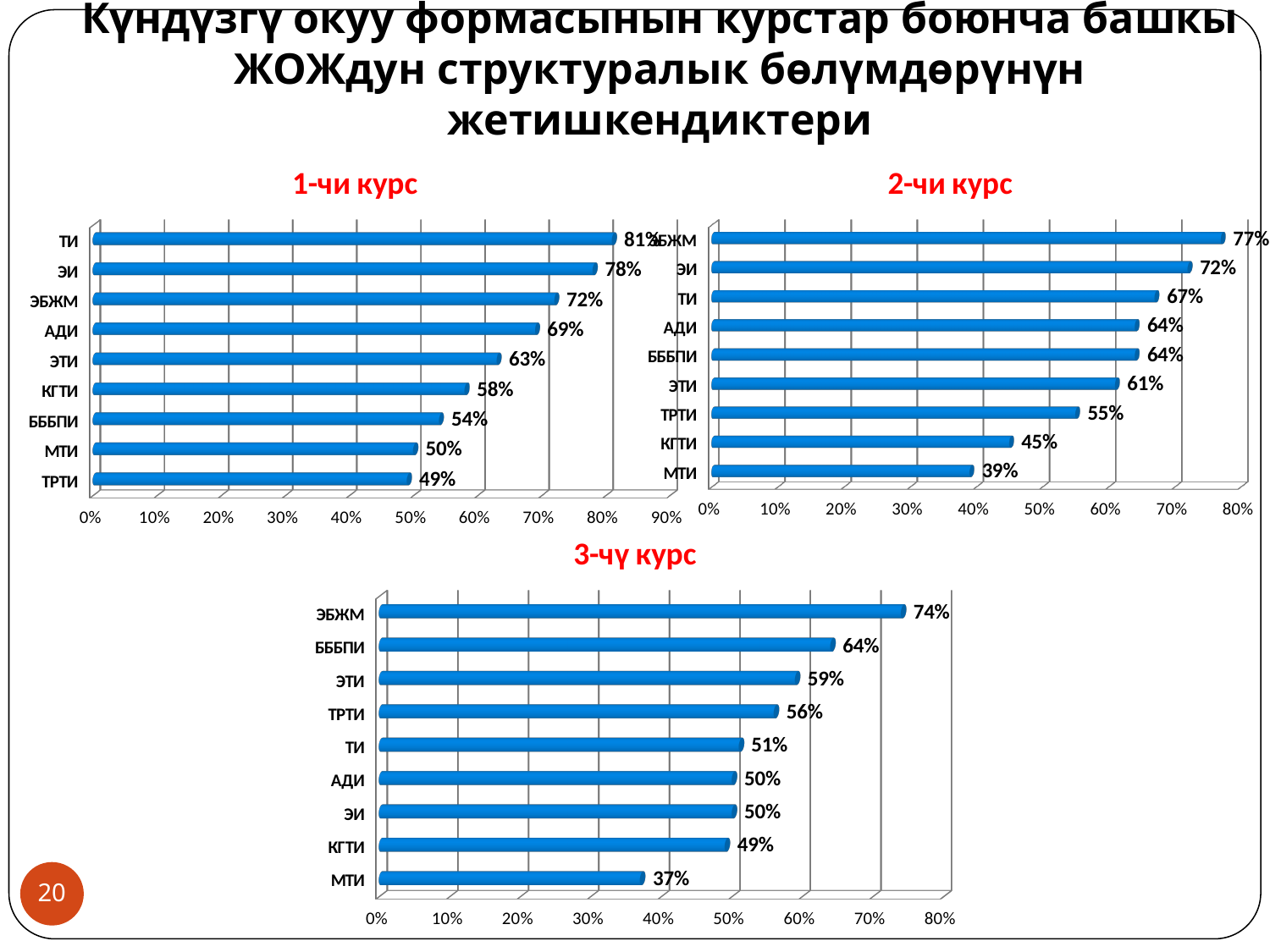
In the "1-чи курс" chart, which category has the lowest value? ТРТИ In the "3-чү курс" chart, what is the value for МТИ? 37% In the "1-чи курс" chart, what is the value for ТИ? 81% In the "1-чи курс" chart, what is the difference between ЭИ and МТИ? 28% In the "2-чи курс" chart, which category has the highest value? ЭБЖМ In the "2-чи курс" chart, which is larger, ЭИ or ЭТИ? ЭИ In the "3-чү курс" chart, which category has the highest value? ЭБЖМ What kind of chart is the "3-чү курс" chart? Bar chart In the "2-чи курс" chart, how many categories are shown? 9 How many charts are shown on the slide? 3 In the "2-чи курс" chart, what is the value for КГТИ? 45% In the "3-чү курс" chart, what is the difference between ЭБЖМ and БББПИ? 10%